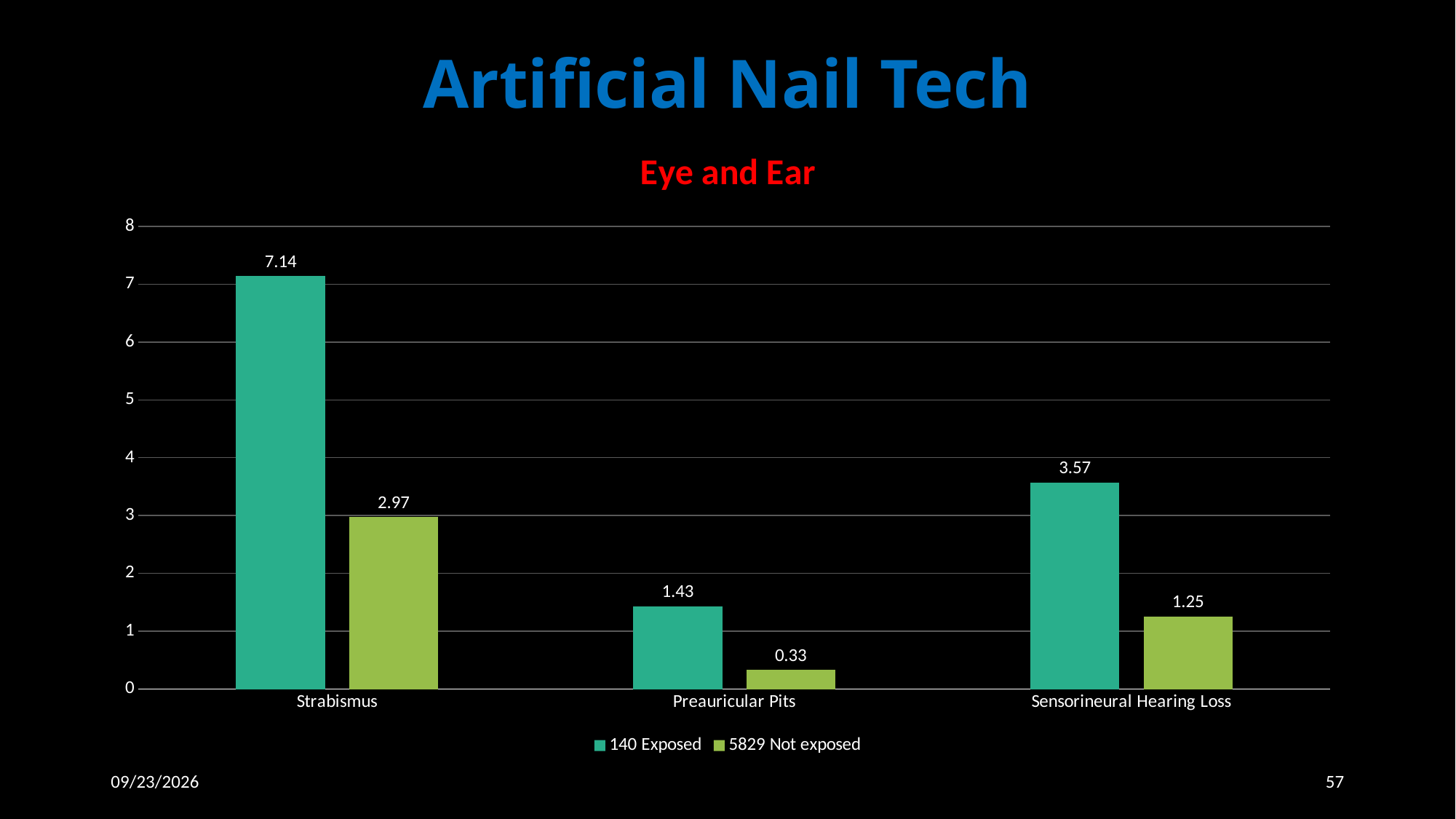
What kind of chart is shown on the slide? bar chart Which category has the lowest value in the 5829 Not exposed series? Preauricular Pits What is the difference between the 140 Exposed and 5829 Not exposed values for Strabismus? 4.17 Is the 5829 Not exposed value for Sensorineural Hearing Loss greater or less than 2? less How many categories are shown on the x axis? 3 What is the value for Strabismus in the 140 Exposed series? 7.14 What is the title of the chart? Eye and Ear Which category has the highest value in the 140 Exposed series? Strabismus How many series does the legend list? 2 What is the value for Preauricular Pits in the 5829 Not exposed series? 0.33 Which is larger for Sensorineural Hearing Loss: the 140 Exposed value or the 5829 Not exposed value? 140 Exposed What is the value for Sensorineural Hearing Loss in the 140 Exposed series? 3.57